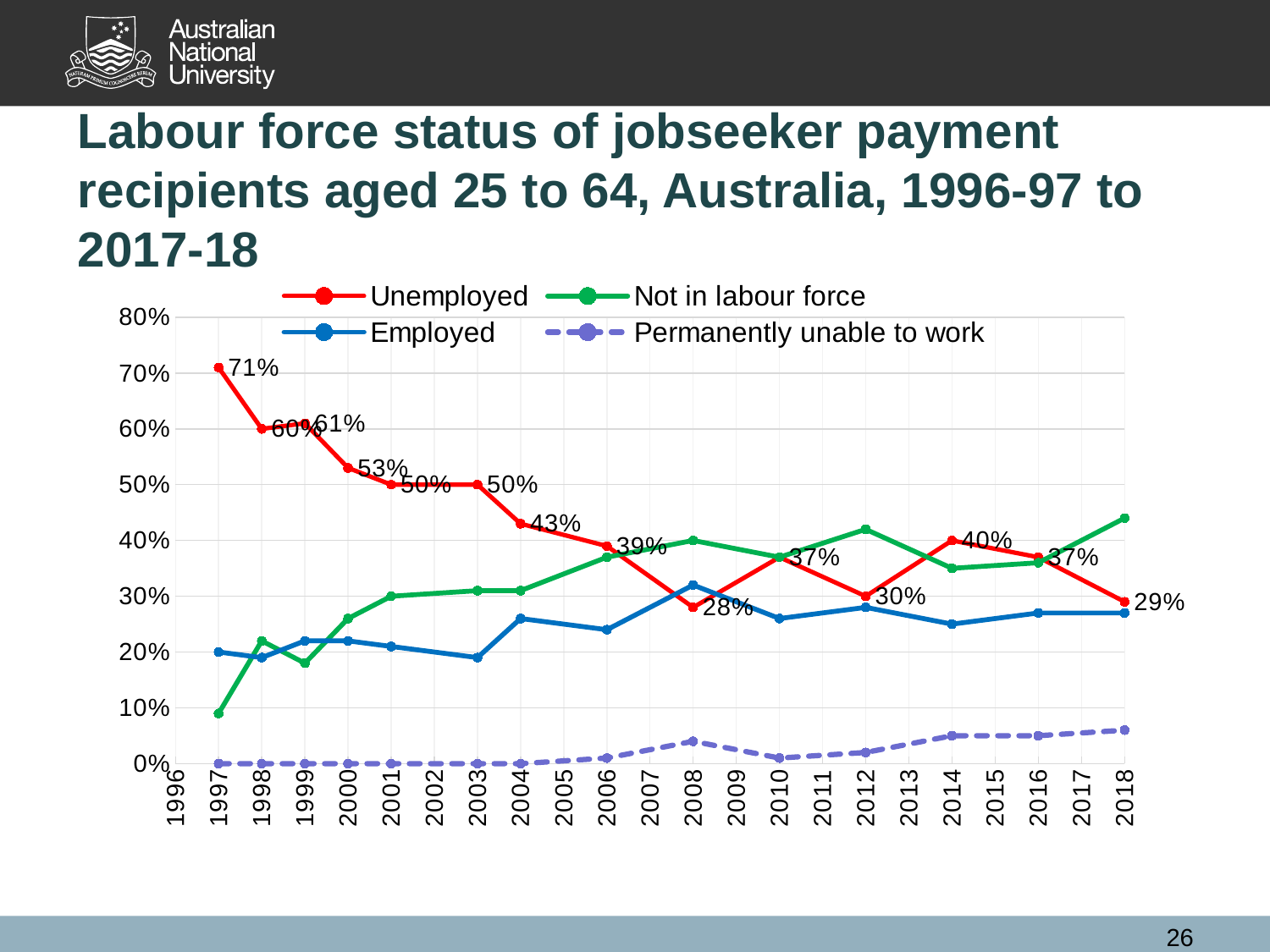
Does the Not in labour force series generally rise or fall from 1997 to 2018? rise In which year is the Unemployed series at its highest? 1997 What type of chart is shown on the slide? line chart What is the Unemployed value in 2008? 28% What is the Unemployed value in 1997? 71% What is the Unemployed value in 2018? 29% Is the Not in labour force value in 2018 greater or less than 40%? greater How many series does the legend list? 4 Is the Permanently unable to work value in 2018 greater or less than 10%? less In which year is the Unemployed series at its lowest? 2008 What is the difference between the Unemployed value in 1997 and in 2018? 42 percentage points Which is larger, the Unemployed value in 2014 or in 2016? 2014